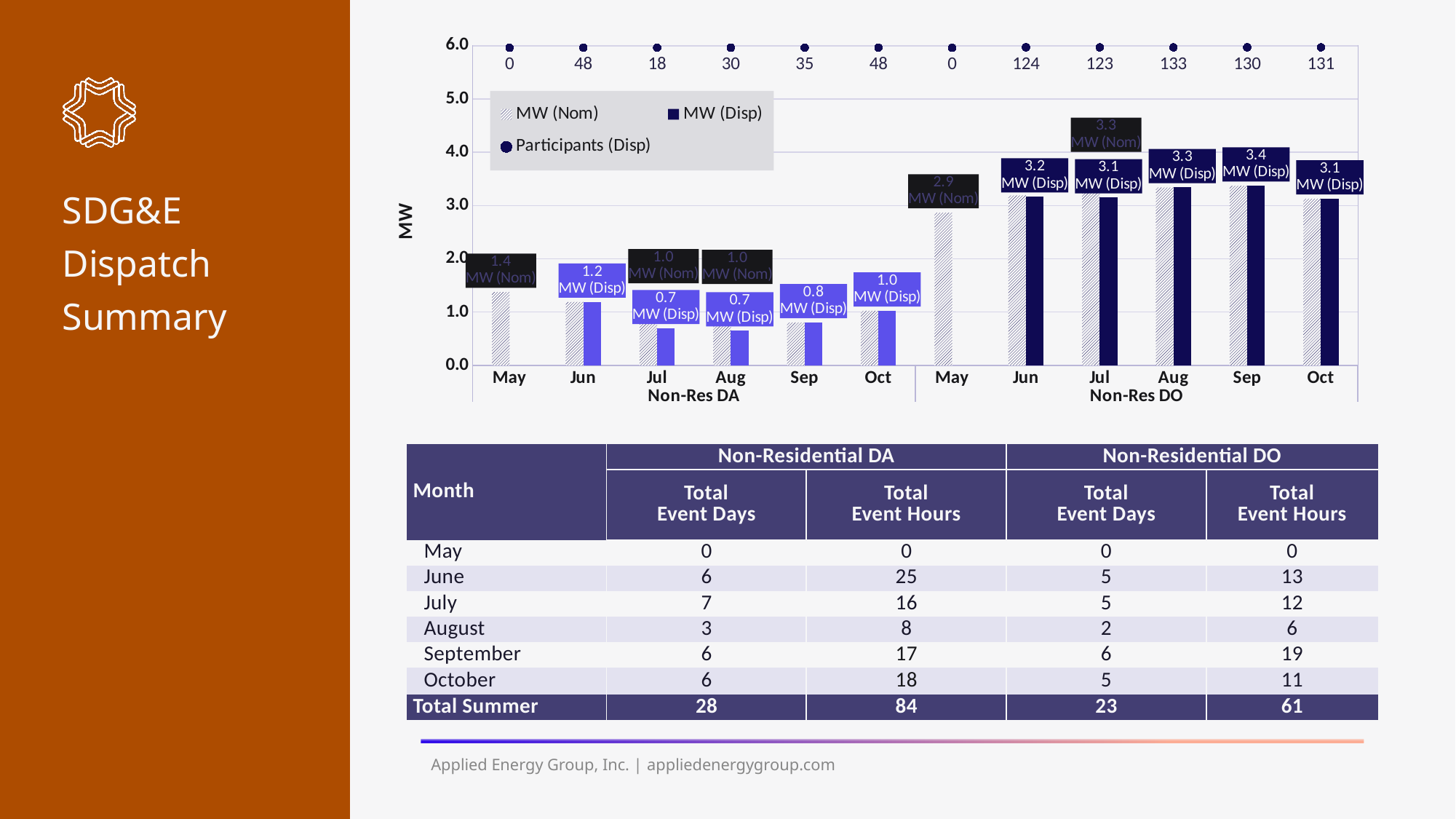
Which month in the Non-Res DO group has the highest MW (Disp) value? Sep What is the difference between the MW (Disp) values for Jun and Jul in the Non-Res DA group? 0.5 What is the MW (Nom) value for May in the Non-Res DO group? 2.9 Is the MW (Nom) value for Jun in the Non-Res DO group greater or less than 3.0? greater How many series does the chart legend list? 3 What is the MW (Disp) value for Jun in the Non-Res DA group? 1.2 What is the label on the vertical axis of the chart? MW How many Participants (Disp) are shown for Aug in the Non-Res DO group? 133 Which is larger, the MW (Disp) value for Oct in Non-Res DA or the MW (Disp) value for Oct in Non-Res DO? Oct in Non-Res DO What kind of chart is shown on the slide? bar chart What is the MW (Disp) value for Sep in the Non-Res DO group? 3.4 How many Participants (Disp) are shown for Jul in the Non-Res DA group? 18